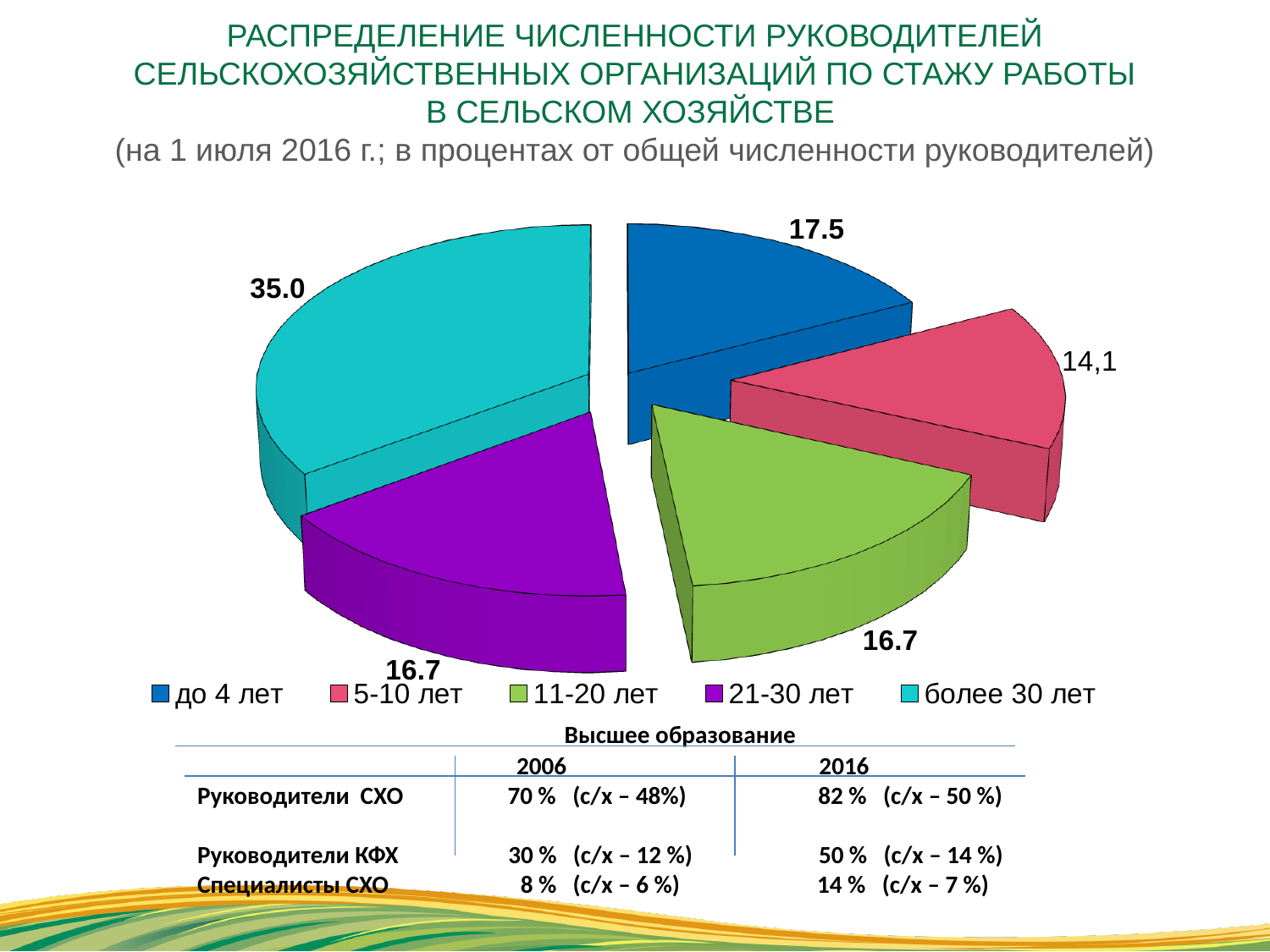
What is the difference between the values for 'более 30 лет' and 'до 4 лет'? 17.5 What colour is the 'более 30 лет' slice in the pie chart? Cyan Which category has the largest slice in the pie chart? более 30 лет What value is shown for the 'до 4 лет' slice of the pie chart? 17.5 How many slices does the pie chart have? 5 What value is shown for the '5-10 лет' slice of the pie chart? 14,1 Which category has the smallest slice in the pie chart? 5-10 лет What is the difference between the values for 'до 4 лет' and '5-10 лет'? 3.4 What type of chart is shown on the slide? Pie chart What value is shown for the '21-30 лет' slice of the pie chart? 16.7 Which is larger: the slice for 'до 4 лет' or the slice for '11-20 лет'? до 4 лет What value is shown for the 'более 30 лет' slice of the pie chart? 35.0